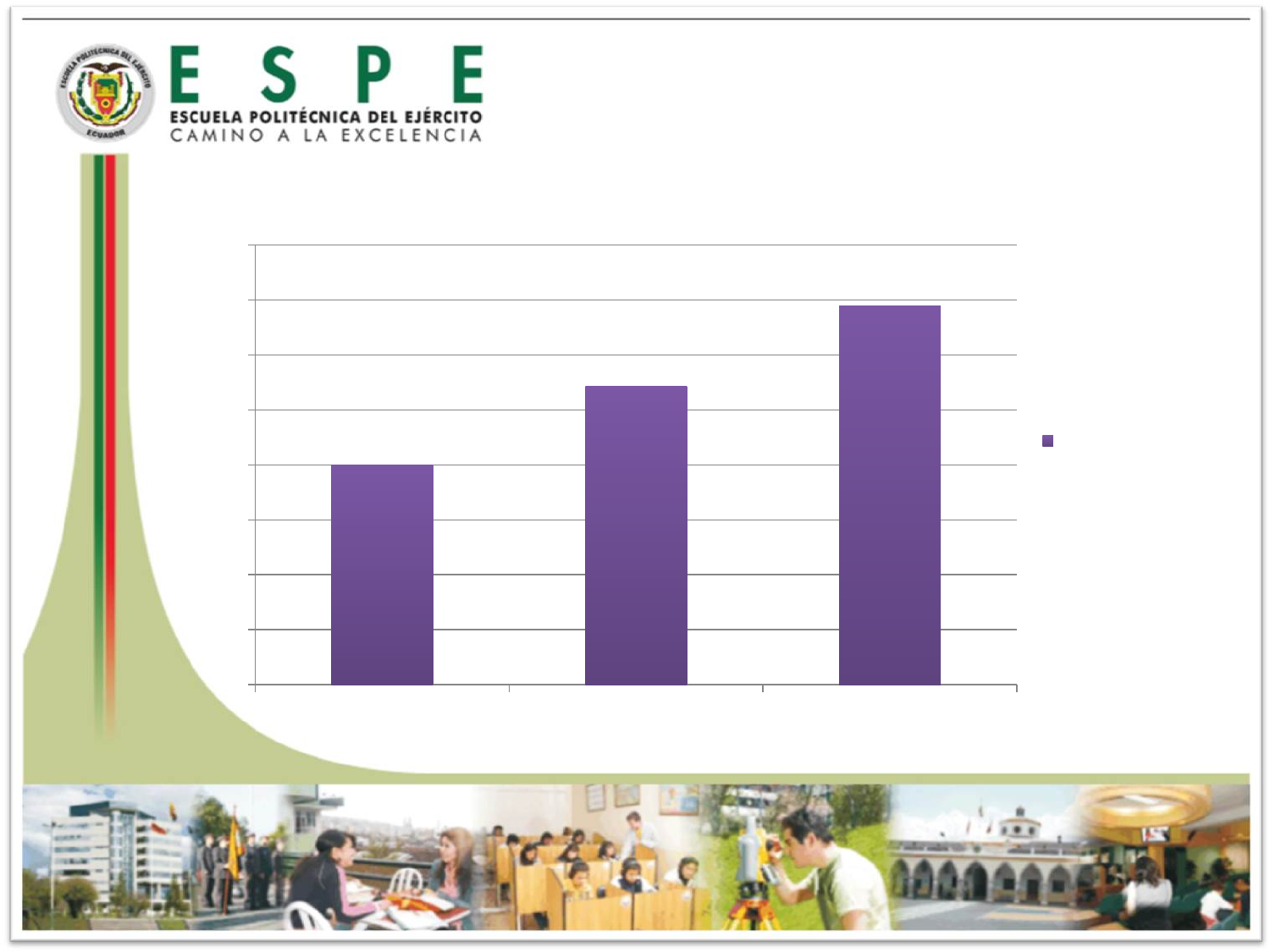
What kind of chart is shown on the slide? bar chart What colour are the bars in the chart? purple Do the bar values rise or fall from left to right? rise Which bar is the tallest: the left, middle, or right one? right Which bar is the shortest: the left, middle, or right one? left How many bars does the chart contain? 3 Which is taller, the right bar or the middle bar? the right bar Are the bars in the chart vertical or horizontal? vertical How many series does the legend list? 1 Which is taller, the middle bar or the left bar? the middle bar